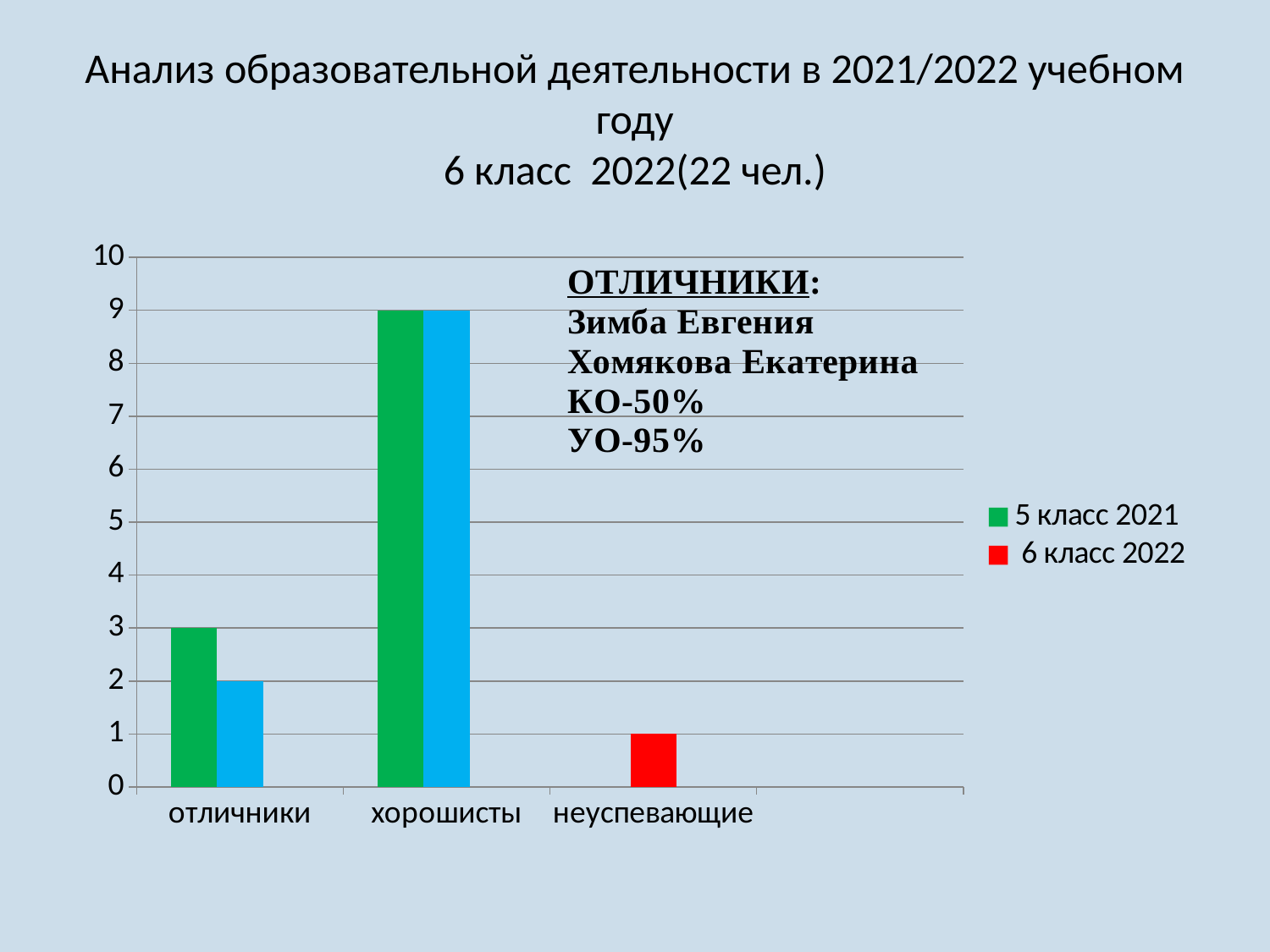
What is the value of the green bar (5 класс 2021) for хорошисты? 9 What is the value of the blue bar for отличники? 2 Which legend entry is shown in green? 5 класс 2021 What is the value of the red bar for неуспевающие? 1 What kind of chart is shown on the slide? bar chart How many series does the chart legend list? 2 How many categories are shown on the x axis of the chart? 3 What is the value of the green bar (5 класс 2021) for отличники? 3 Which is larger for отличники: the green bar or the blue bar? the green bar Is the value of the green bar for хорошисты greater or less than 5? greater Which category has the highest value for the green bars (5 класс 2021)? хорошисты What is the difference between the green bar and the blue bar for отличники? 1